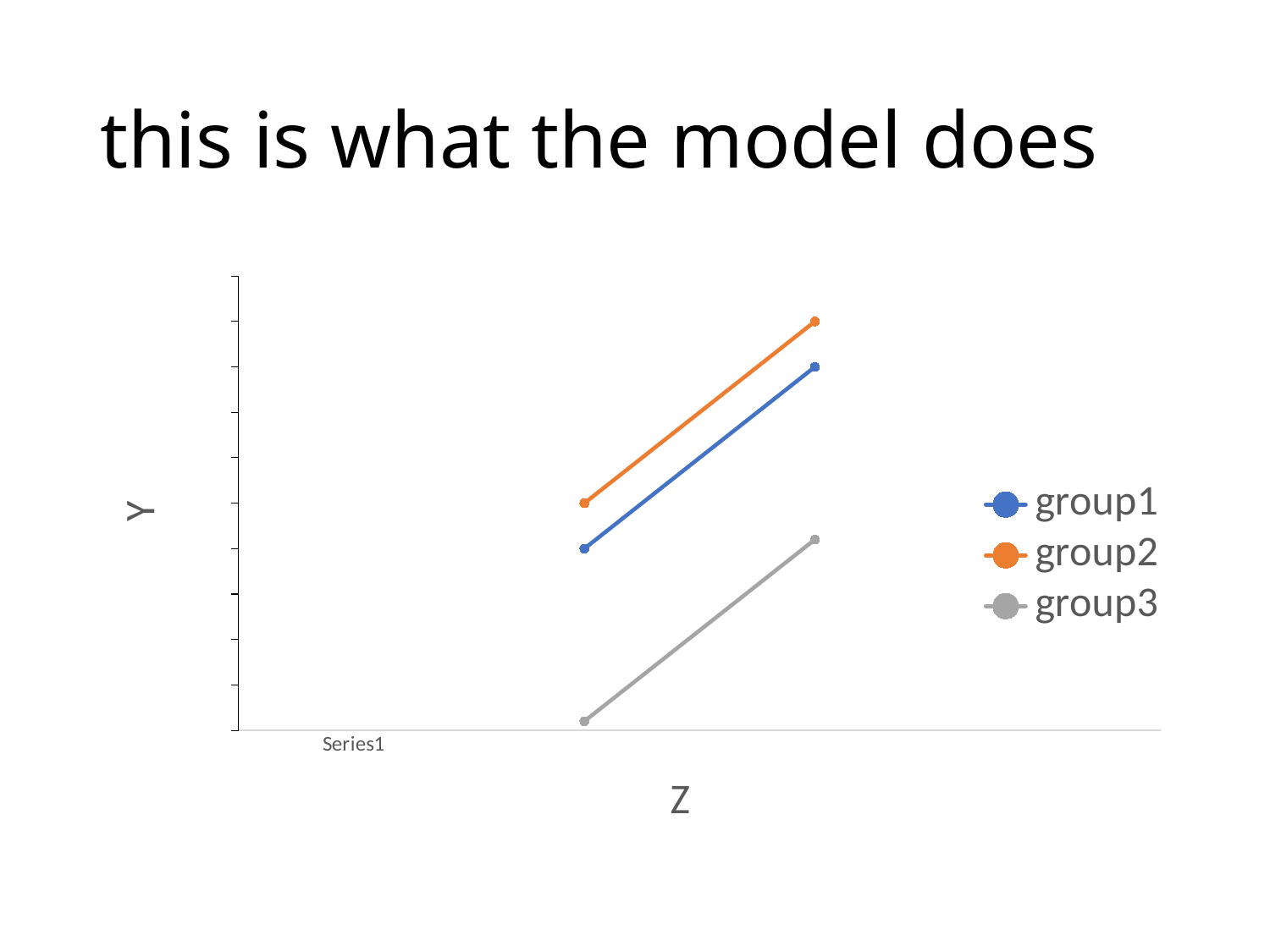
Which series has the lowest values on the chart? group3 Which series is higher at the left-hand point, group2 or group1? group2 Which series is higher at the right-hand point, group1 or group3? group1 What kind of chart is shown on the slide? line chart How many data points are plotted for each series? 2 Which series are listed in the legend? group1, group2, group3 How many series does the legend list? 3 What is the label on the vertical axis of the chart? Y Do the values for group3 rise or fall from left to right along the x axis? rise Which series has the highest values on the chart? group2 Do the values for group1 rise or fall from left to right along the x axis? rise Do the values for group2 rise or fall from left to right along the x axis? rise